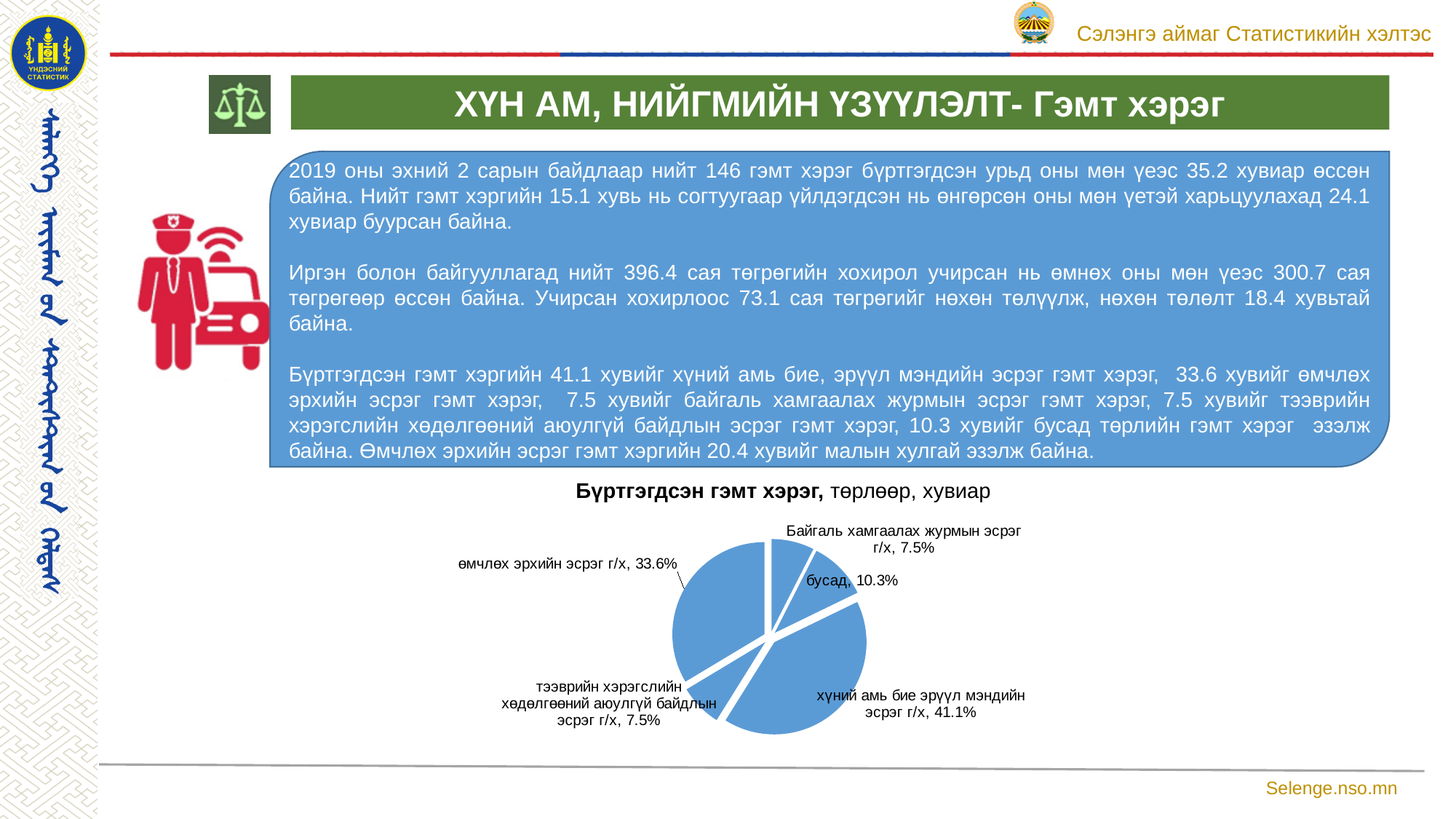
Which category has the largest slice of the pie? хүний амь бие эрүүл мэндийн эсрэг г/х How many slices does the pie chart have? 5 What is the difference between the shares of 'бусад' and 'тээврийн хэрэгслийн хөдөлгөөний аюулгүй байдлын эсрэг г/х'? 2.8% What type of chart is shown on the slide? pie chart What share of the pie is 'өмчлөх эрхийн эсрэг г/х'? 33.6% What value is shown for 'бусад'? 10.3% What share of the pie is 'хүний амь бие эрүүл мэндийн эсрэг г/х'? 41.1% Which is larger, the share for 'бусад' or the share for 'Байгаль хамгаалах журмын эсрэг г/х'? бусад What value is shown for 'Байгаль хамгаалах журмын эсрэг г/х'? 7.5% What value is shown for 'тээврийн хэрэгслийн хөдөлгөөний аюулгүй байдлын эсрэг г/х'? 7.5% What is the title of the chart? Бүртгэгдсэн гэмт хэрэг, төрлөөр, хувиар What is the difference between the shares of 'хүний амь бие эрүүл мэндийн эсрэг г/х' and 'өмчлөх эрхийн эсрэг г/х'? 7.5%